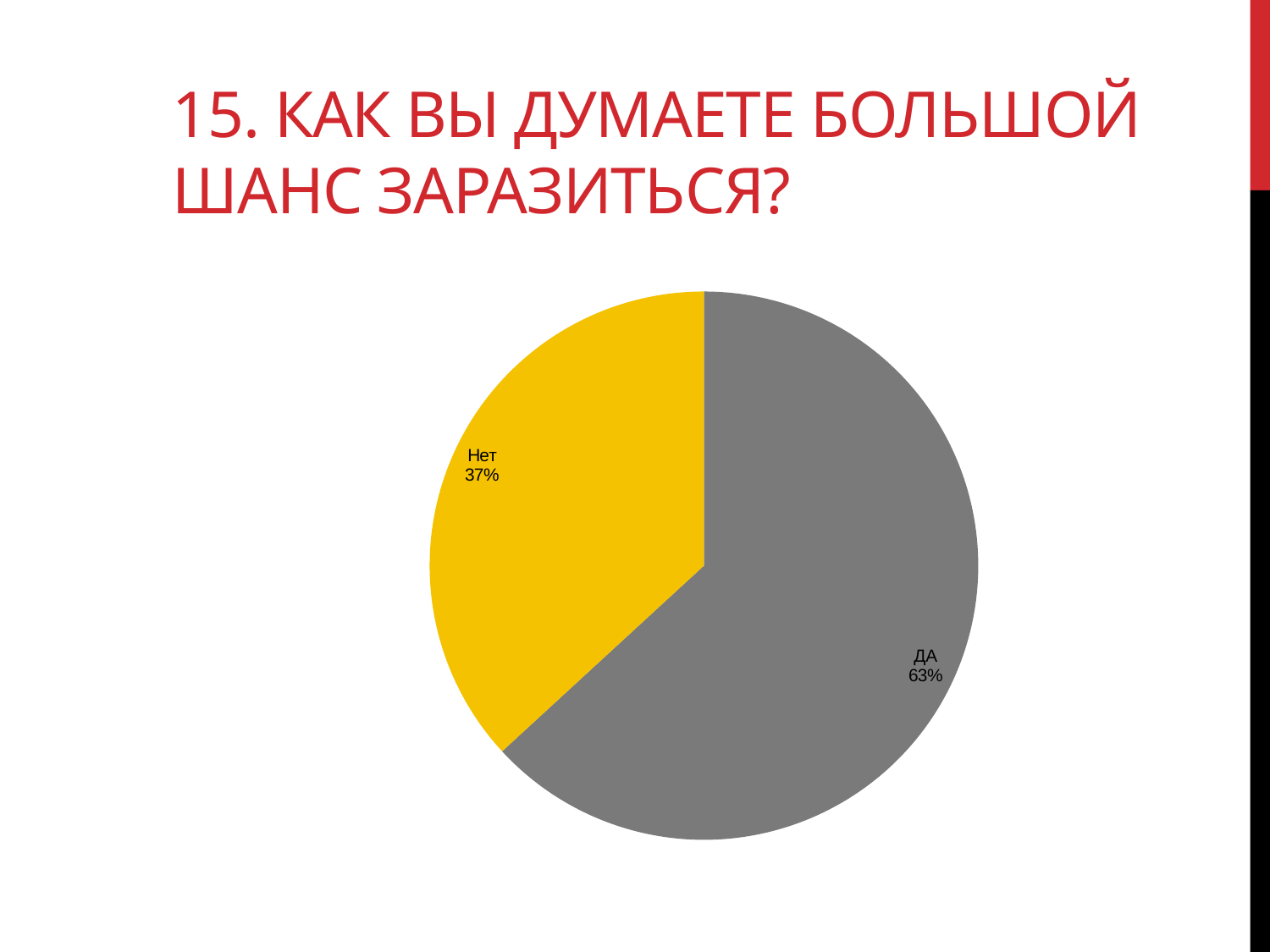
Which slice is the smallest in the pie chart? Нет What share of the pie does the "ДА" slice represent? 63% What colour is the "ДА" slice? grey Which slice is the largest in the pie chart? ДА What share of the pie does the "Нет" slice represent? 37% How many slices does the pie chart have? 2 What is the difference in percentage points between the "ДА" and "Нет" slices? 26 Which is larger, the "ДА" slice or the "Нет" slice? ДА What colour is the "Нет" slice? yellow What kind of chart is shown on the slide? pie chart